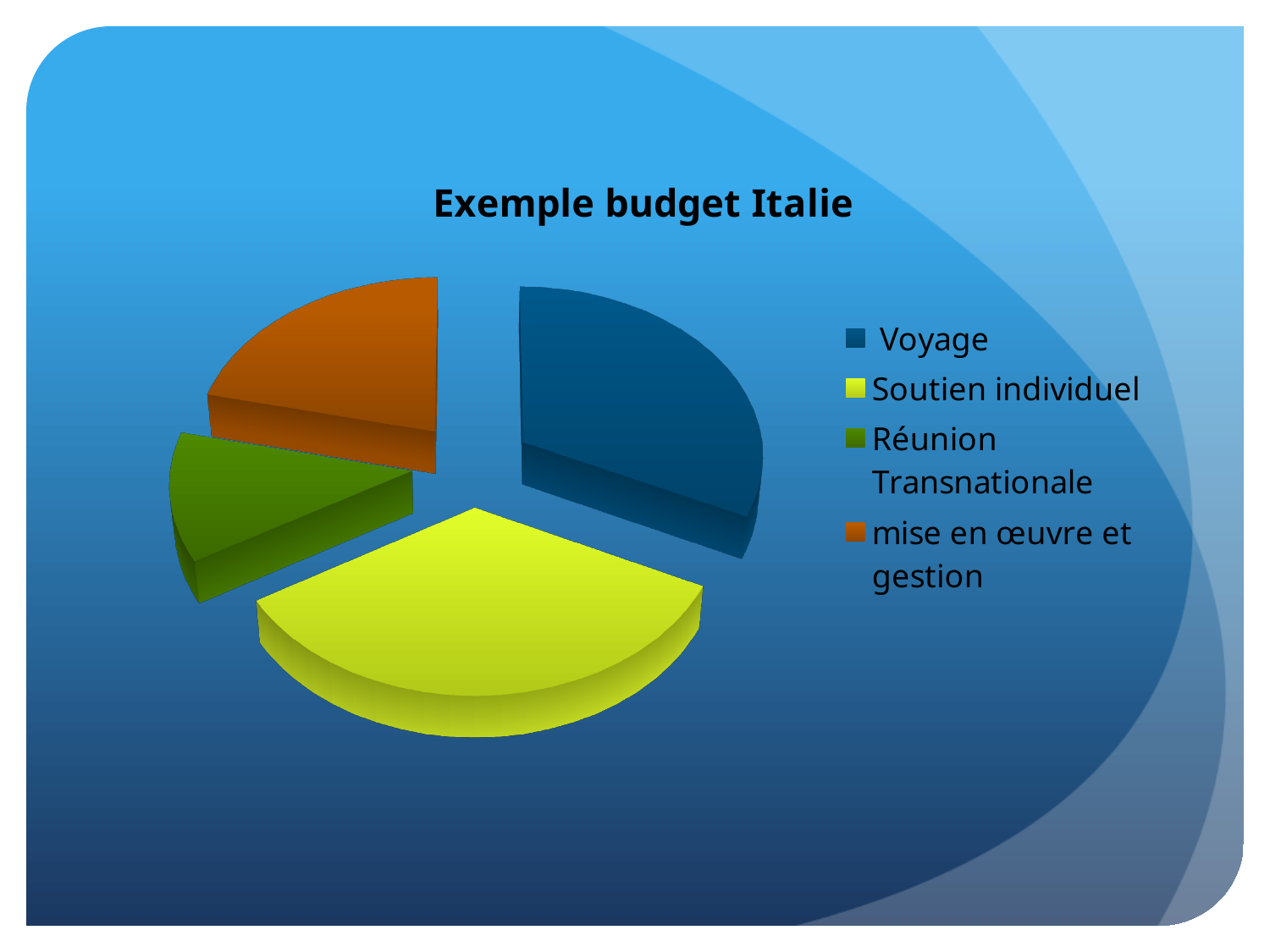
What kind of chart is shown on the slide? pie chart What is the title of the chart? Exemple budget Italie Which slice is larger, mise en œuvre et gestion or Réunion Transnationale? mise en œuvre et gestion Which category has the largest slice of the pie? Soutien individuel How many entries does the legend list? 4 What colour is the Voyage slice in the pie chart? blue Which slice is larger, Soutien individuel or Voyage? Soutien individuel Which category has the smallest slice of the pie? Réunion Transnationale Which slice is larger, Soutien individuel or Réunion Transnationale? Soutien individuel How many slices does the pie chart have? 4